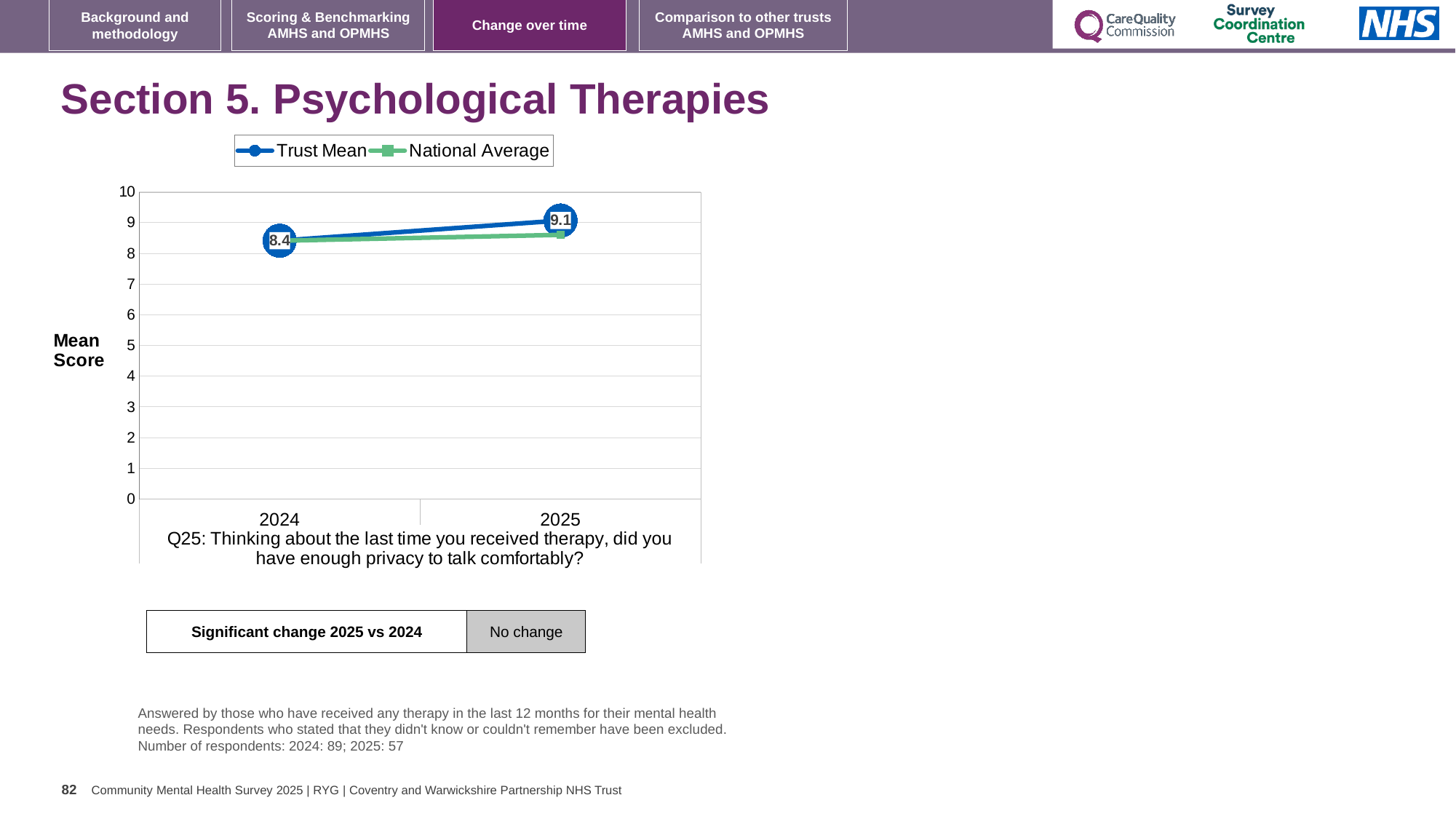
How many series does the legend list? 2 What kind of chart is shown on the slide? line chart How many years are plotted on the x axis? 2 Does the Trust Mean rise or fall from 2024 to 2025? rise What is the Trust Mean value for 2024? 8.4 In which year is the Trust Mean lower? 2024 Is the National Average value for 2025 greater or less than 8? greater What is the Trust Mean value for 2025? 9.1 What is the label on the y axis of the chart? Mean Score In 2025, which is larger: the Trust Mean or the National Average? Trust Mean By how much did the Trust Mean change from 2024 to 2025? 0.7 In which year is the Trust Mean higher? 2025